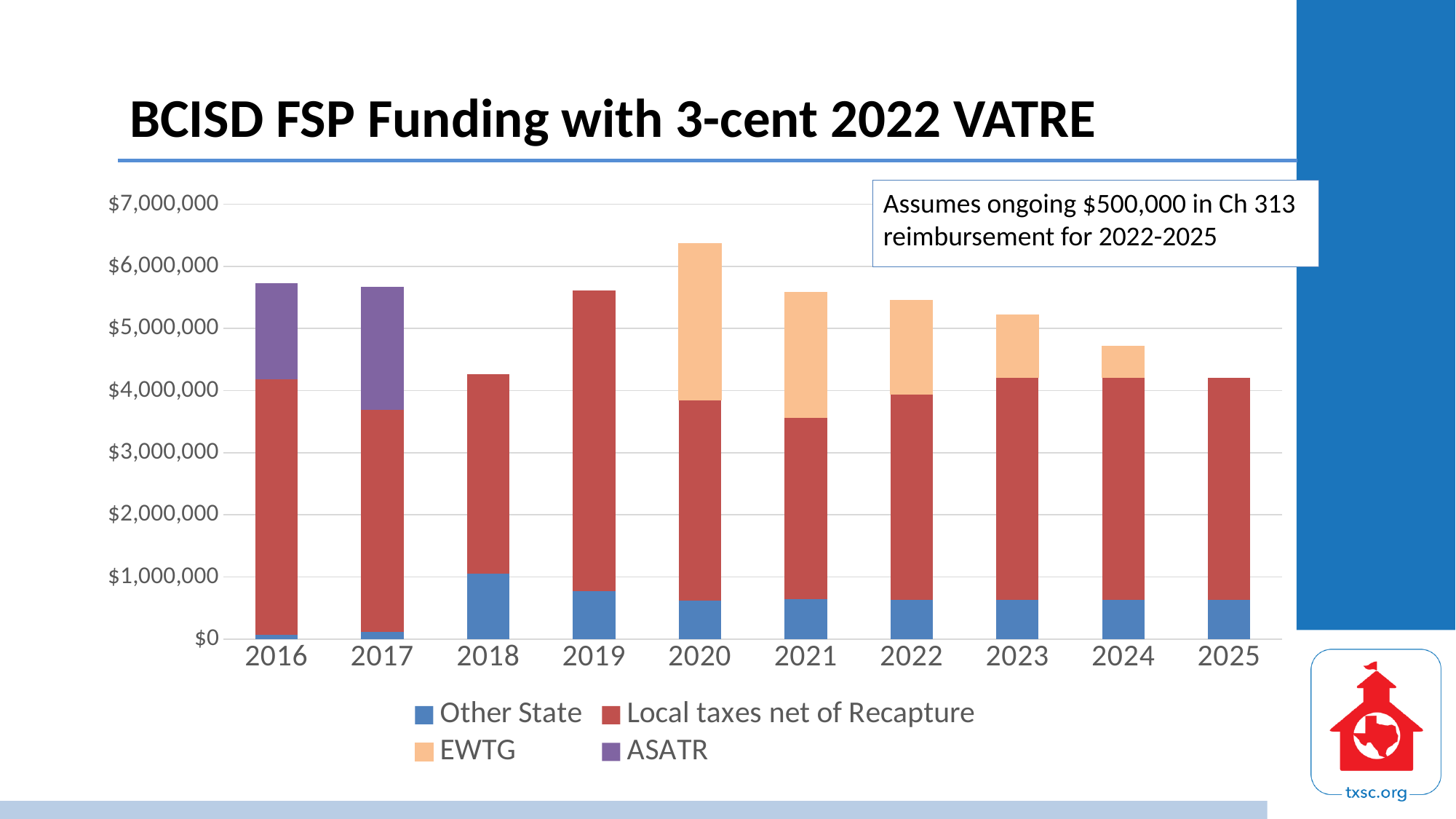
How many years are shown on the x axis of the chart? 10 Is the total funding for 2016 greater or less than $5,000,000? greater In which years does the ASATR series appear in the chart? 2016 and 2017 Is the total funding for 2020 greater or less than $6,000,000? greater Which year has the highest total FSP funding? 2020 Do the total funding bars rise or fall from 2020 to 2025? Fall What is the title of the chart on the slide? BCISD FSP Funding with 3-cent 2022 VATRE Is the total funding for 2018 greater or less than $5,000,000? less Which year has the larger total funding, 2019 or 2020? 2020 What kind of chart is shown on the slide? Stacked bar chart How many series does the chart's legend list? 4